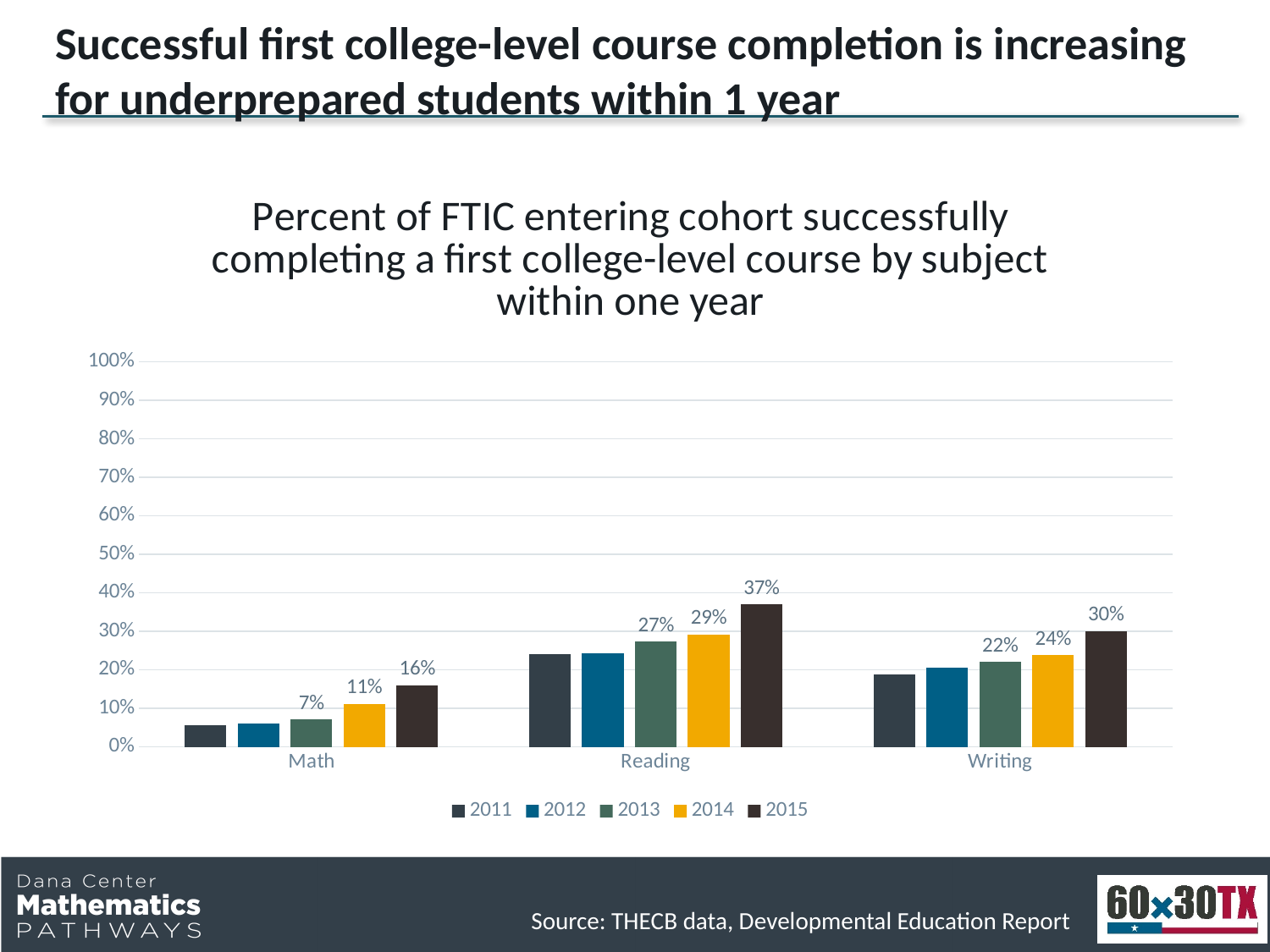
Is the value for 2011 in the Reading category greater or less than 30%? less What is the value for 2014 in the Writing category? 24% Which subject has the highest value for 2015? Reading Which is larger: the 2015 value for Writing or the 2014 value for Reading? 2015 value for Writing What is the difference between the 2015 and 2013 values for Reading? 10% How many series does the legend list? 5 Which subject has the lowest value for 2014? Math How many subject categories are shown on the x axis? 3 What kind of chart is shown on the slide? bar chart What is the value for 2013 in the Math category? 7% Within the Math category, do the values rise or fall from 2013 to 2015? rise What is the value for 2015 in the Reading category? 37%